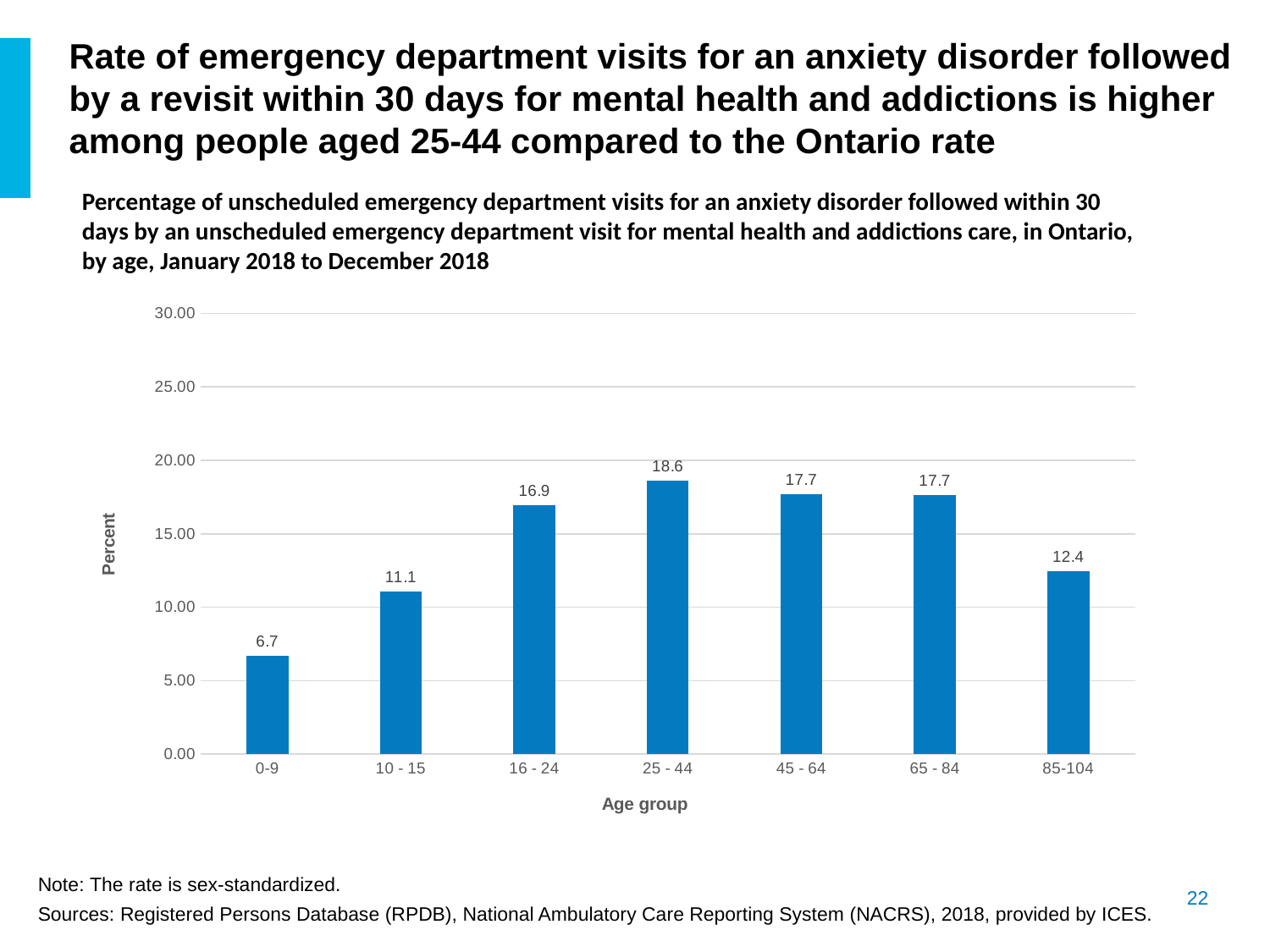
What is the difference between the values for the 16 - 24 and 10 - 15 age groups? 5.8 What kind of chart is shown on the slide? bar chart Which age group has the lowest value? 0-9 How many age groups are shown on the x axis? 7 What is the value for the 0-9 age group? 6.7 Is the value for the 10 - 15 age group greater or less than 15.00? less What is the label of the y axis? Percent What is the value for the 25 - 44 age group? 18.6 Which is larger, the value for 16 - 24 or the value for 85-104? 16 - 24 What is the difference between the values for the 25 - 44 and 0-9 age groups? 11.9 What is the value for the 85-104 age group? 12.4 Which age group has the highest value? 25 - 44